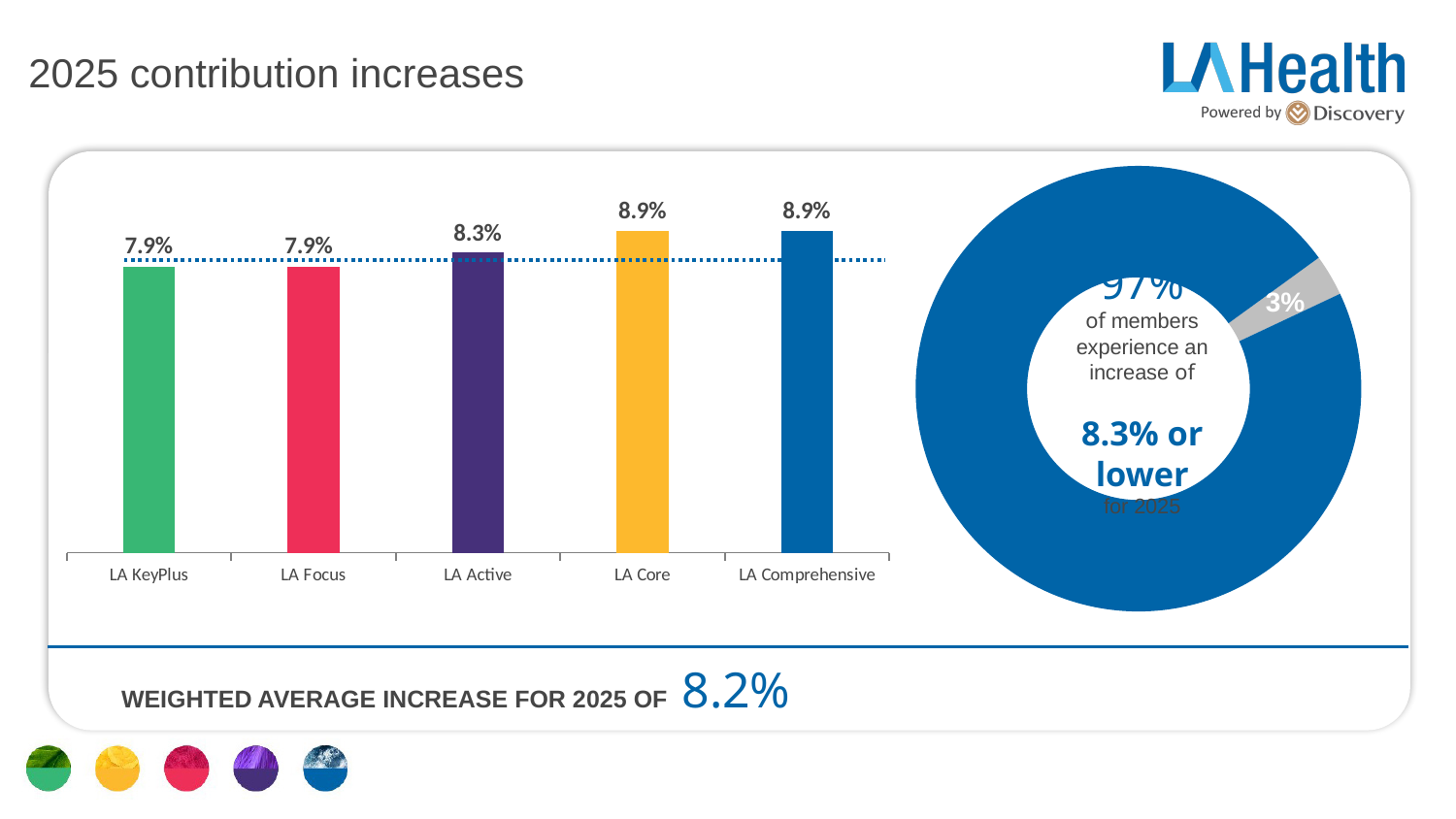
In the bar chart on the left, what is the contribution increase for LA KeyPlus? 7.9% What is the weighted average increase for 2025 stated on the slide? 8.2% In the bar chart on the left, what is the difference between the increase for LA Comprehensive and the increase for LA Focus? 1.0 percentage points (8.9% − 7.9%) In the bar chart on the left, what is the contribution increase for LA Active? 8.3% In the bar chart on the left, which plan has the lowest contribution increase? LA KeyPlus and LA Focus (both 7.9%) In the bar chart on the left, what is the contribution increase for LA Core? 8.9% How many plans are shown in the bar chart on the left? 5 In the donut chart on the right, what share of members experience an increase of 8.3% or lower for 2025? 97% What kind of chart is shown on the left of the slide? Bar chart In the bar chart on the left, which is larger: the increase for LA Active or the increase for LA Focus? LA Active In the donut chart on the right, what is the value of the grey slice? 3% In the bar chart on the left, do the values rise or fall from LA KeyPlus to LA Comprehensive? Rise